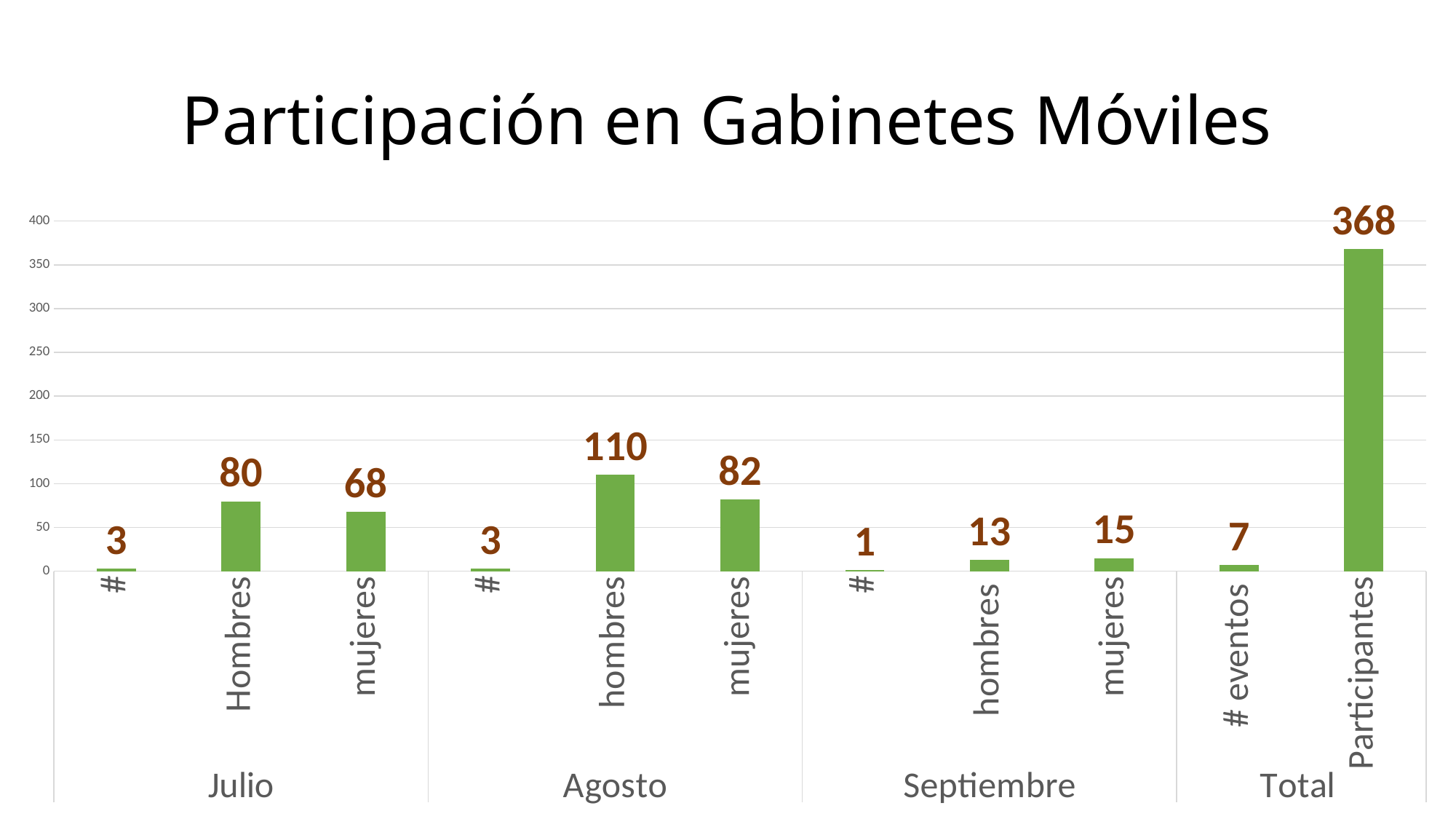
What is the value for # eventos in the Total group? 7 Which is larger, hombres in Septiembre or mujeres in Septiembre? mujeres in Septiembre How many bars are plotted in the chart? 11 What is the value for mujeres in Agosto? 82 What is the difference between hombres and mujeres in Agosto? 28 What is the value for Hombres in Julio? 80 What kind of chart is shown on the slide? bar chart Which bar has the highest value? Participantes What is the title of the chart? Participación en Gabinetes Móviles Is the value for hombres in Agosto greater or less than 100? greater What is the value for Participantes in the Total group? 368 Which bar has the lowest value? # in Septiembre